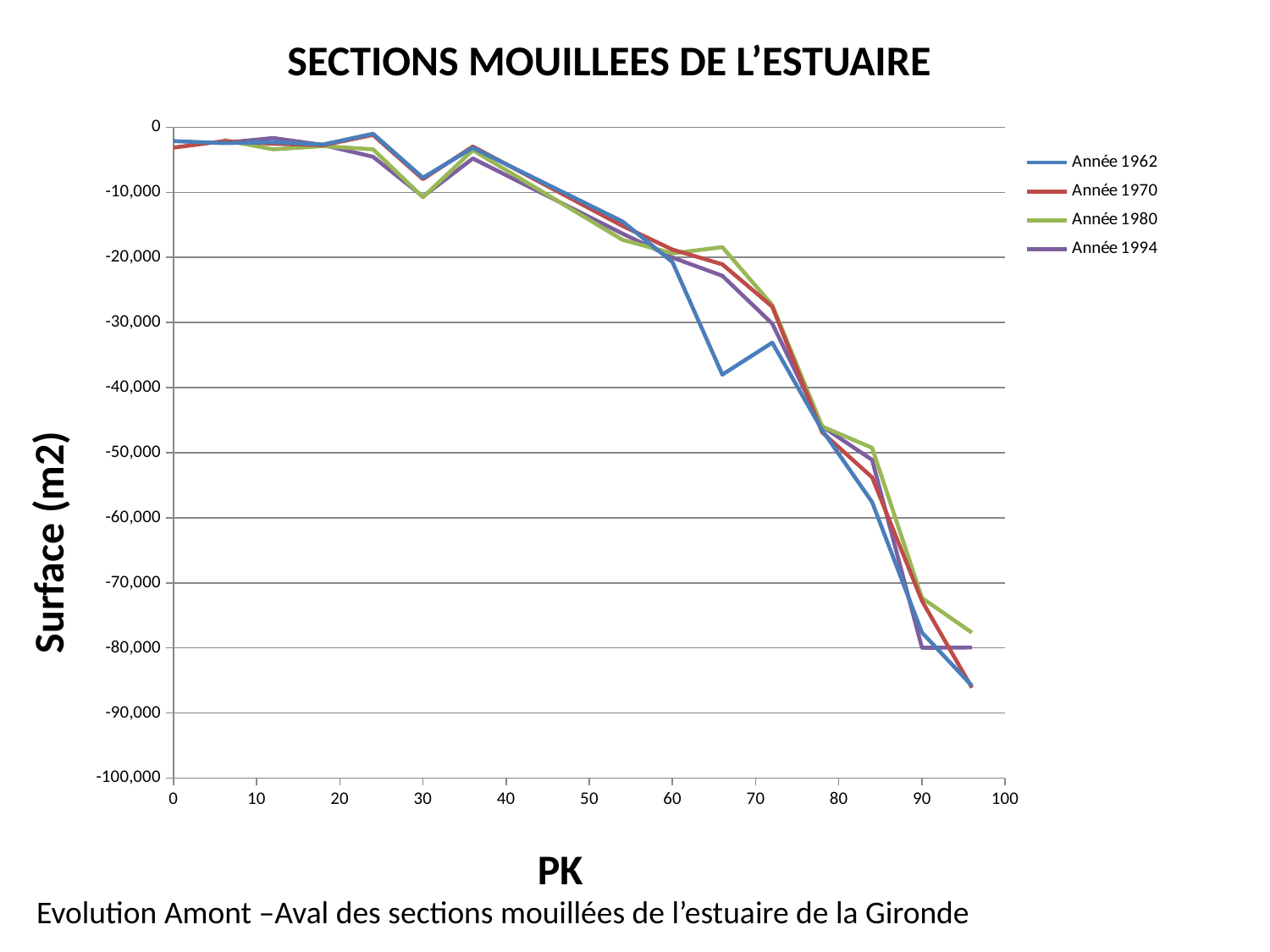
At PK 66, which series has the higher value, Année 1962 or Année 1980? Année 1980 Is the value for Année 1994 at PK 54 greater or less than -10,000? less How many series does the legend list? 4 What is the title of the chart? SECTIONS MOUILLEES DE L'ESTUAIRE Is the value for Année 1980 at PK 84 greater or less than -60,000? greater What kind of chart is shown on the slide? line chart Is the value for Année 1970 at PK 96 greater or less than -80,000? less Which series has the lowest value at PK 66? Année 1962 At PK 96, which series has the higher value, Année 1970 or Année 1980? Année 1980 What is the label of the vertical axis? Surface (m2) Do the values generally rise or fall as PK increases from 0 to 100? fall